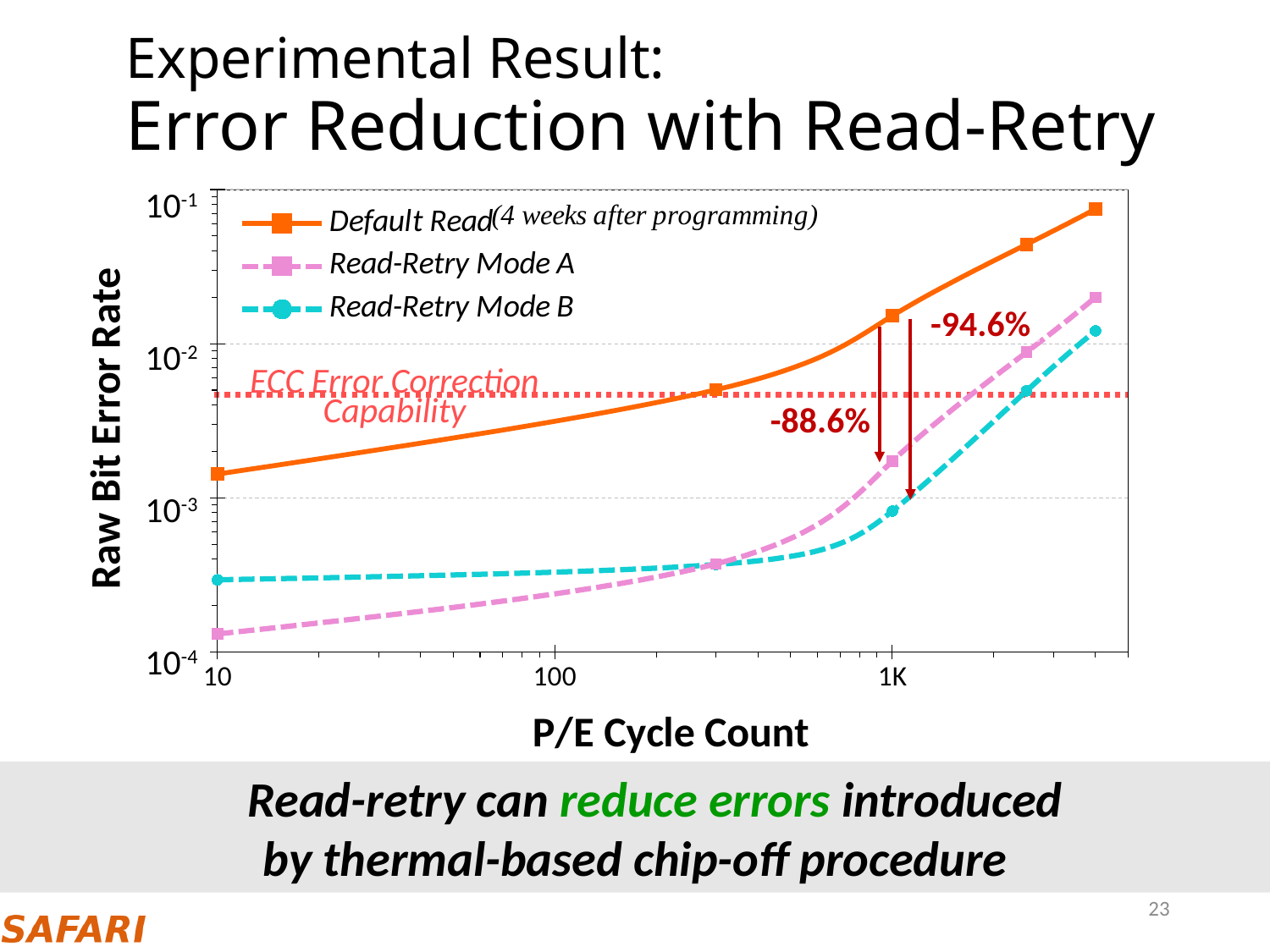
What kind of chart is shown on the slide? line chart Is the Default Read raw bit error rate at 1K P/E cycles greater or less than 10^-2? greater Which series has the lowest raw bit error rate at 10 P/E cycles? Read-Retry Mode A How many series does the legend list? 3 At 10 P/E cycles, which has the higher raw bit error rate, Read-Retry Mode A or Read-Retry Mode B? Read-Retry Mode B What is the label of the x axis? P/E Cycle Count What percentage reduction is annotated for Read-Retry Mode B relative to Default Read at 1K P/E cycles? -94.6% What is the label of the y axis? Raw Bit Error Rate Which series has the highest raw bit error rate at 1K P/E cycles? Default Read Does the raw bit error rate for Default Read rise or fall as the P/E cycle count increases? rise Is the Read-Retry Mode A raw bit error rate at 10 P/E cycles greater or less than 10^-3? less What percentage reduction is annotated for Read-Retry Mode A relative to Default Read at 1K P/E cycles? -88.6%